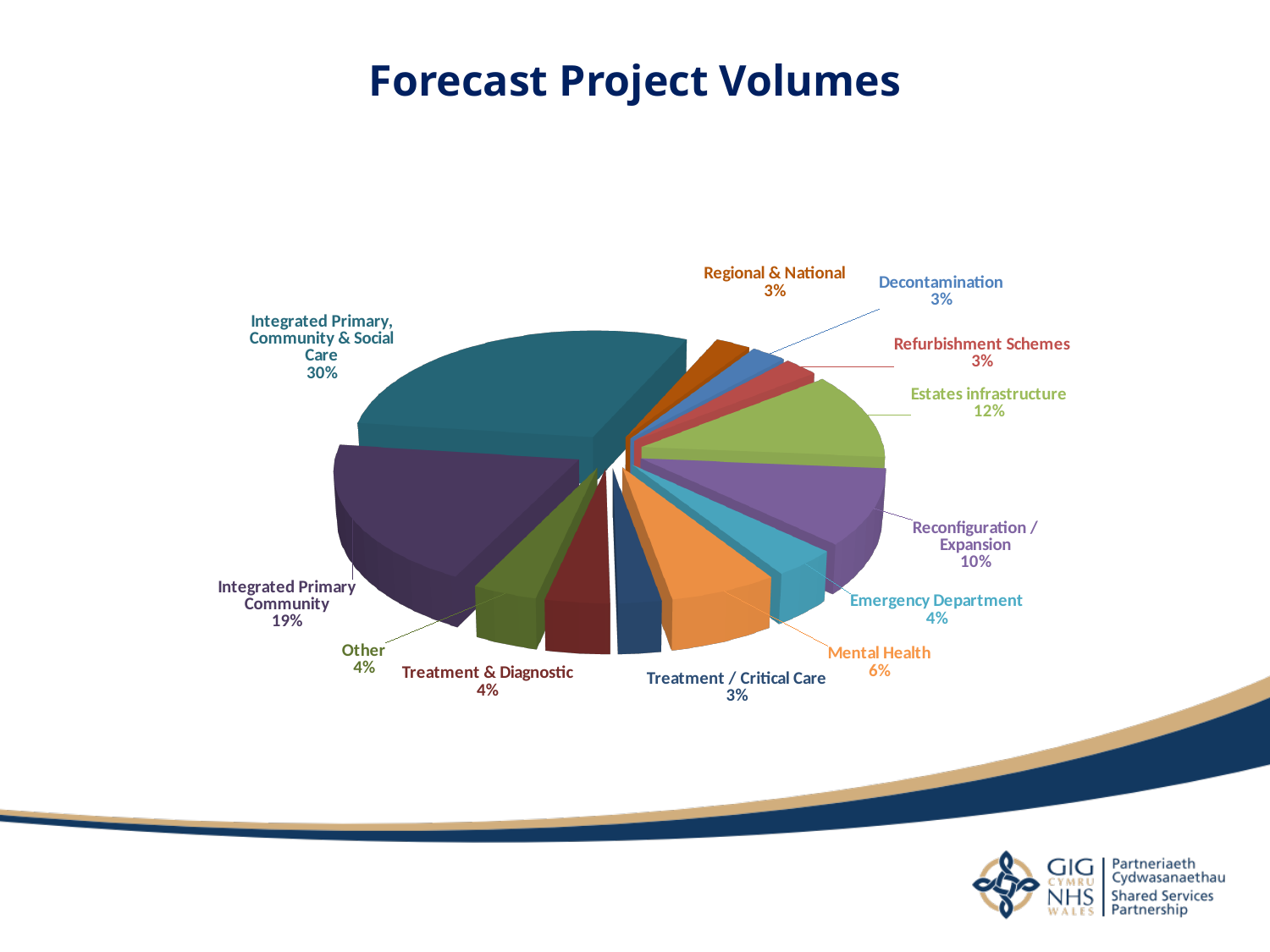
How many categories (slices) does the pie chart have? 12 What percentage is shown for Estates infrastructure? 12% Which category has the largest share of the pie? Integrated Primary, Community & Social Care What percentage is shown for Reconfiguration / Expansion? 10% What is the difference in percentage points between Mental Health and Emergency Department? 2 What share of forecast project volumes is Integrated Primary, Community & Social Care? 30% What is the difference in percentage points between Integrated Primary, Community & Social Care and Integrated Primary Community? 11 What percentage is shown for Mental Health? 6% What percentage is shown for Treatment / Critical Care? 3% What is the title of the chart? Forecast Project Volumes Which is larger, the share for Estates infrastructure or the share for Reconfiguration / Expansion? Estates infrastructure What kind of chart is shown on the slide? Pie chart